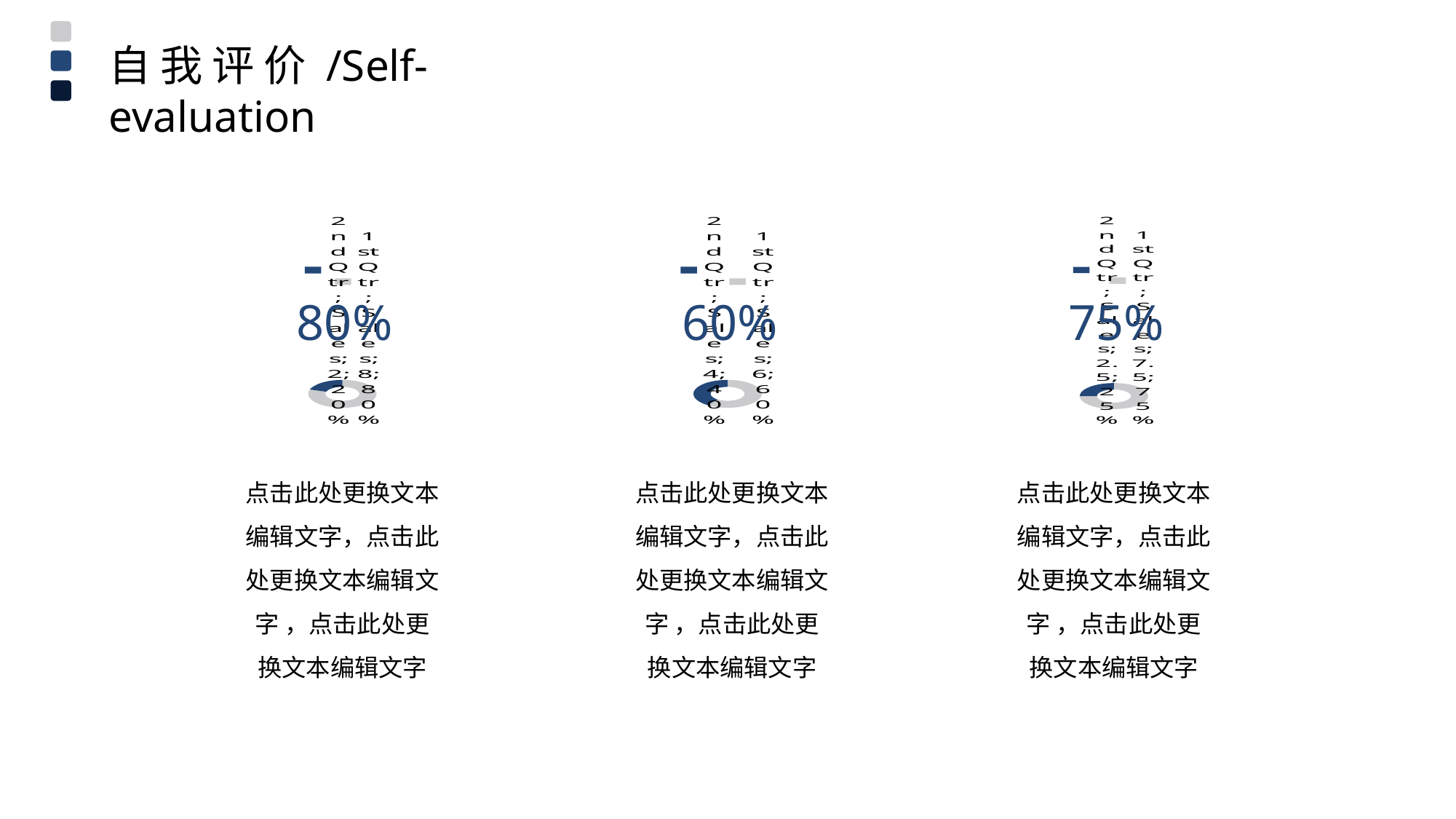
What kind of chart is the left chart on the slide? doughnut (pie) chart In the middle chart, what share does the 2nd Qtr slice have? 40% Which of the three charts has the largest highlighted percentage label? the left chart (80%) What percentage is shown as the large label on the left chart? 80% In the right chart, what share does the 2nd Qtr slice have? 25% In the left chart, what share does the 2nd Qtr slice have? 20% What percentage is shown as the large label on the right chart? 75% What is the difference between the large percentage labels of the left and middle charts? 20% How many entries does the legend of the middle chart list? 2 How many slices does the left doughnut chart have? 2 What percentage is shown as the large label on the middle chart? 60% In the left chart, which slice is larger, 1st Qtr or 2nd Qtr? 1st Qtr